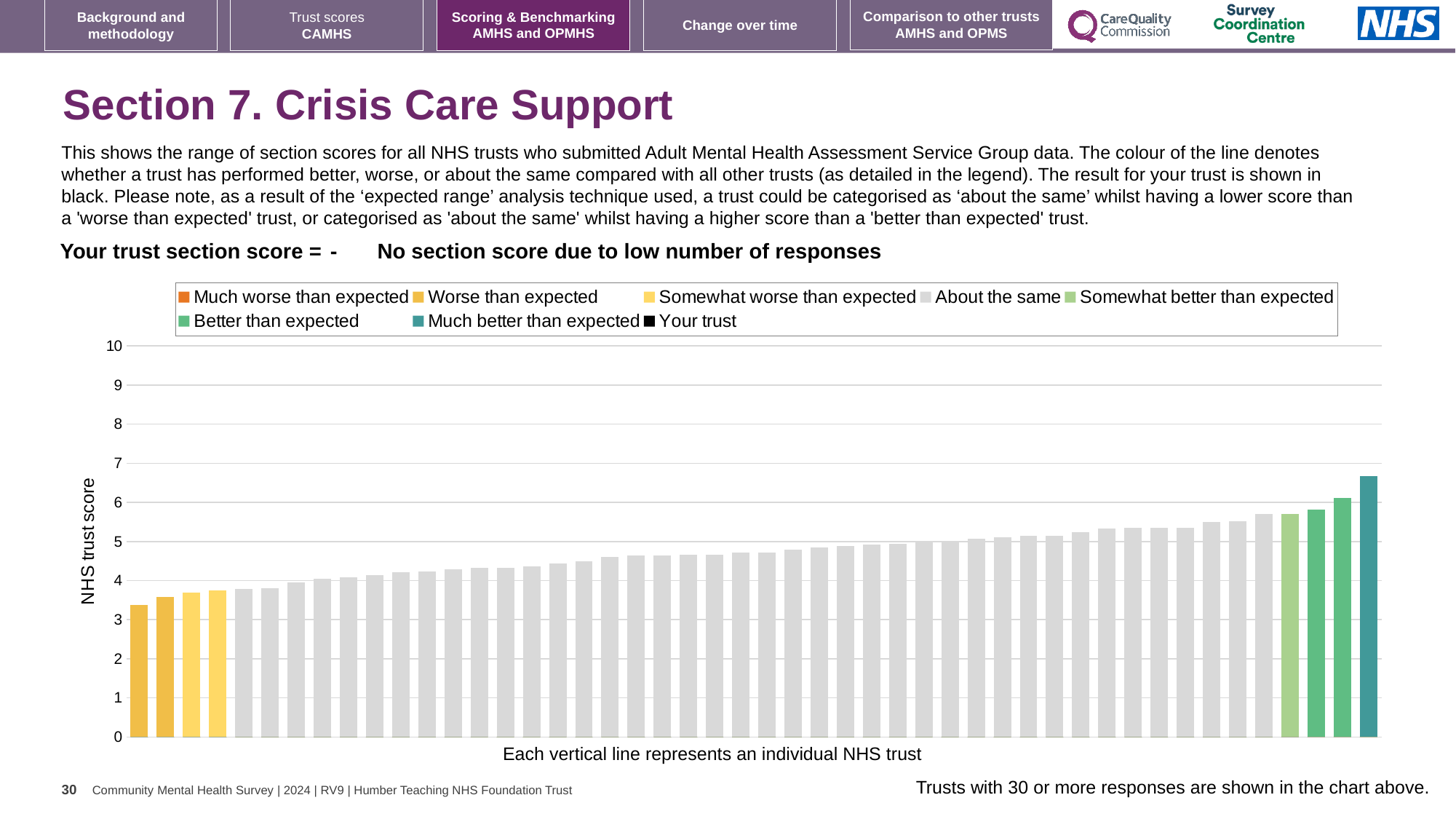
Do the bar values rise or fall from left to right along the x axis? Rise How many bars are coloured as 'Much better than expected'? 1 Is the value of the shortest bar greater or less than 3? greater Is the value of the tallest bar greater or less than 7? less How many bars are coloured as 'Worse than expected'? 2 How many bars are coloured as 'Better than expected'? 2 What kind of chart is shown on the slide? Bar chart Is the value of the tallest bar greater or less than 6? greater What is the label on the vertical axis of the chart? NHS trust score What is the highest value shown on the vertical axis? 10 How many entries does the chart legend list? 8